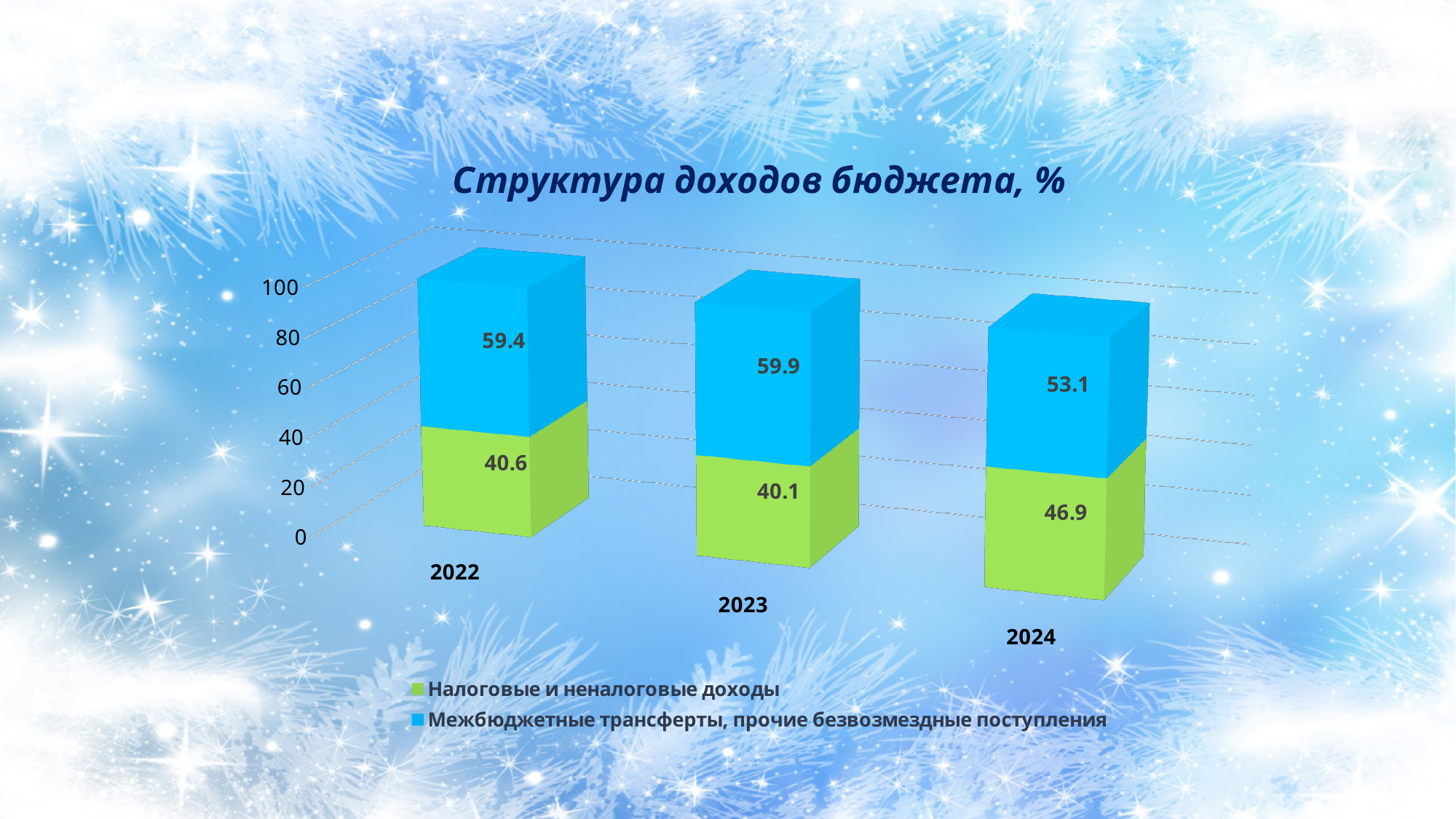
Which is larger in 2024: Налоговые и неналоговые доходы or Межбюджетные трансферты, прочие безвозмездные поступления? Межбюджетные трансферты, прочие безвозмездные поступления What is the value for Налоговые и неналоговые доходы in 2024? 46.9 What is the difference between the Межбюджетные трансферты value and the Налоговые и неналоговые доходы value in 2022? 18.8 How many years are shown on the x axis? 3 What is the value for Налоговые и неналоговые доходы in 2022? 40.6 What kind of chart is shown on the slide? Stacked bar chart How many series does the legend list? 2 What is the value for Межбюджетные трансферты, прочие безвозмездные поступления in 2023? 59.9 In which year is the value for Межбюджетные трансферты, прочие безвозмездные поступления the lowest? 2024 What is the value for Межбюджетные трансферты, прочие безвозмездные поступления in 2024? 53.1 What is the title of the chart? Структура доходов бюджета, % In which year is the value for Налоговые и неналоговые доходы the highest? 2024